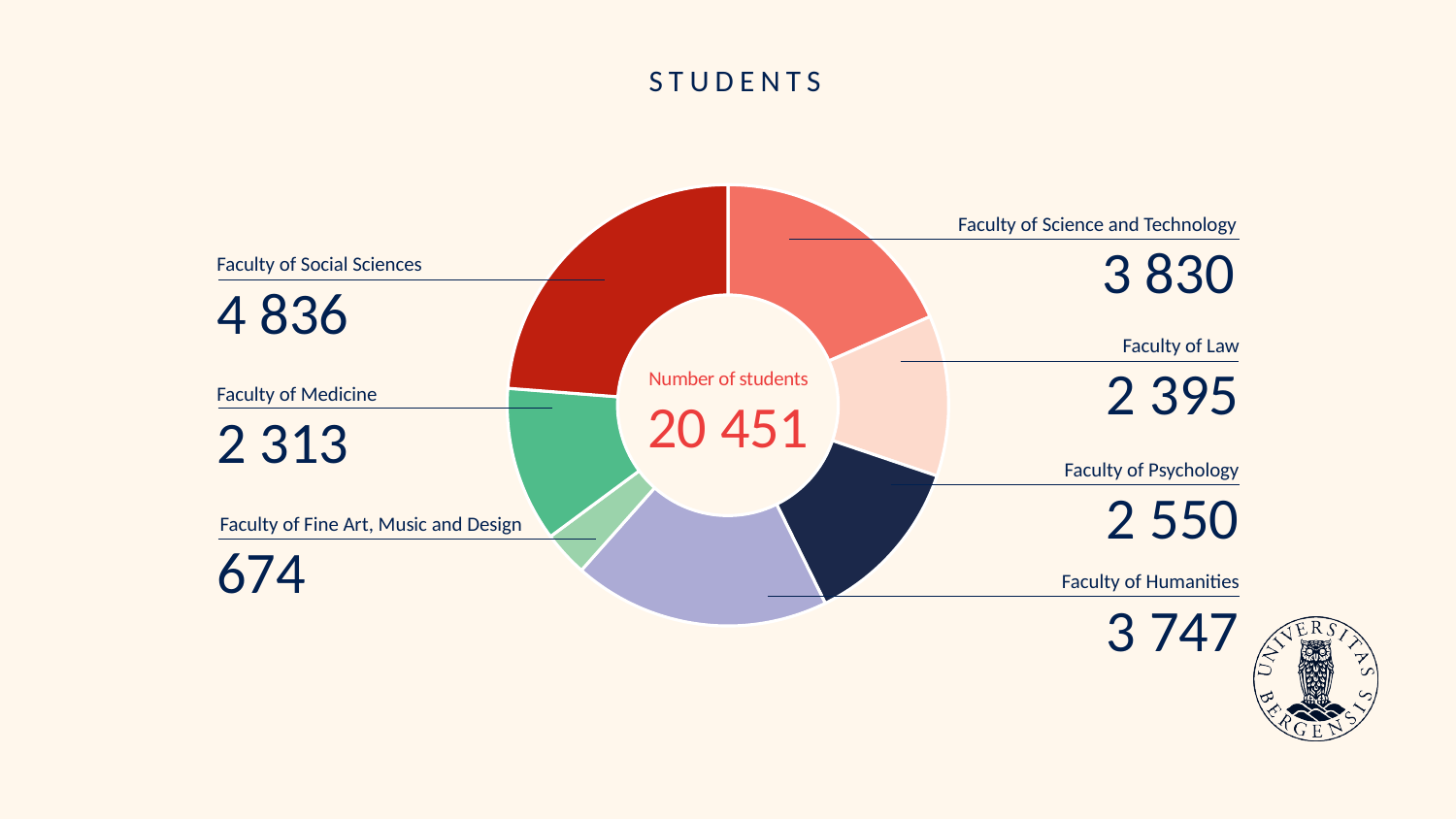
What total number of students is shown in the centre of the chart? 20 451 What kind of chart is shown on the slide? Doughnut chart Which faculty has the lowest number of students? Faculty of Fine Art, Music and Design Which faculty has the highest number of students? Faculty of Social Sciences How many faculties are shown in the chart? 7 Which has more students, the Faculty of Psychology or the Faculty of Law? Faculty of Psychology What is the difference in student numbers between the Faculty of Social Sciences and the Faculty of Science and Technology? 1 006 How many students are in the Faculty of Social Sciences? 4 836 What is the number of students for the Faculty of Law? 2 395 Which has more students, the Faculty of Humanities or the Faculty of Medicine? Faculty of Humanities What is the number of students for the Faculty of Fine Art, Music and Design? 674 What is the difference in student numbers between the Faculty of Psychology and the Faculty of Law? 155